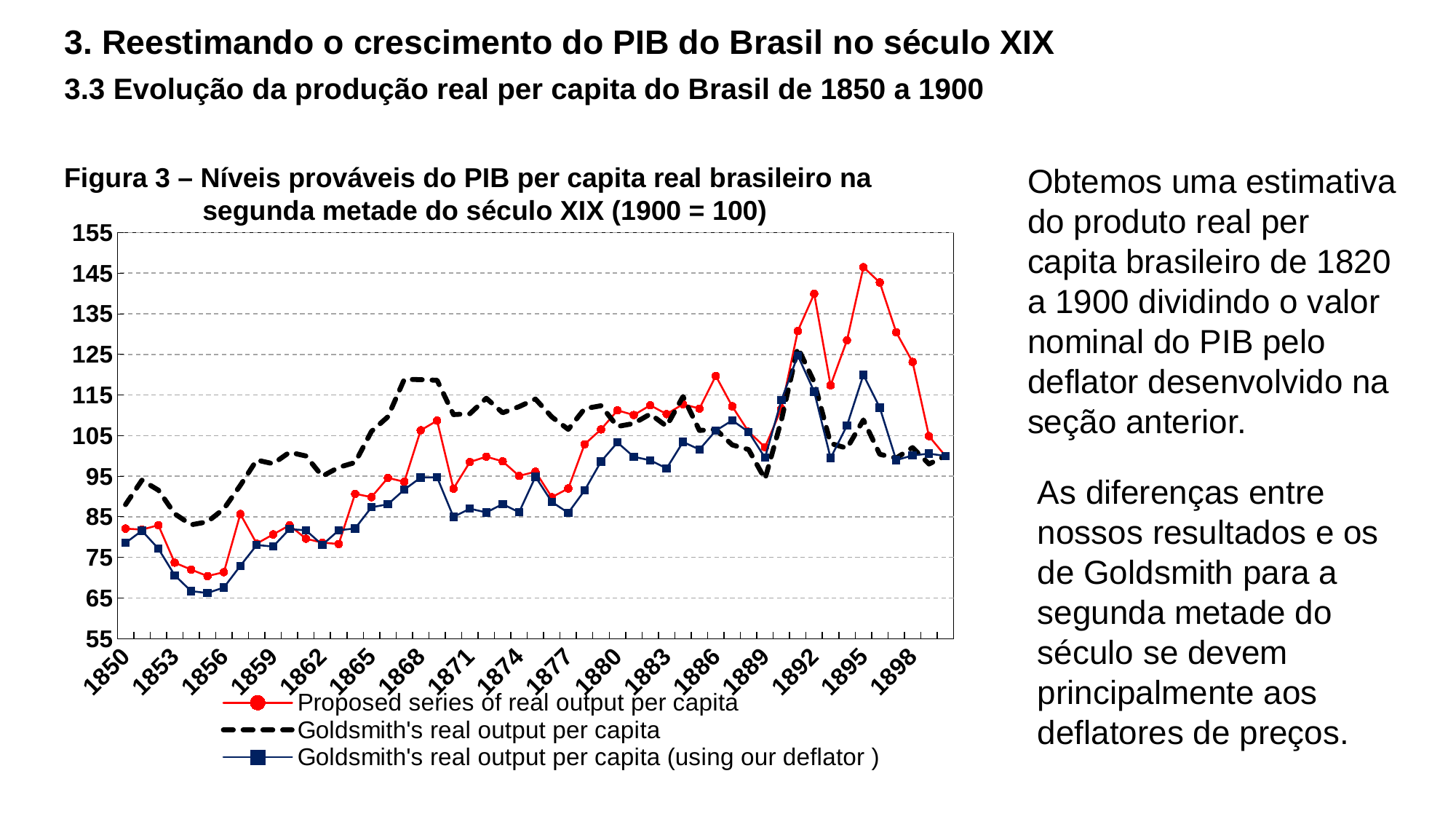
In which year does 'Goldsmith's real output per capita (using our deflator)' reach its highest value? 1891 Which series in Figura 3 is drawn as a black dashed line? Goldsmith's real output per capita How many series does the legend of Figura 3 list? 3 Does the 'Proposed series of real output per capita' rise or fall between 1895 and 1900? fall Is the value of 'Goldsmith's real output per capita (using our deflator)' in 1856 greater or less than 75? less What kind of chart is shown in Figura 3? line chart What base year is indicated in the title of Figura 3 (index = 100)? 1900 Is the value of the 'Proposed series of real output per capita' in 1892 greater or less than 135? greater In which year does the 'Proposed series of real output per capita' reach its highest value? 1895 In 1895, which is larger: the 'Proposed series of real output per capita' or 'Goldsmith's real output per capita' (dashed line)? Proposed series of real output per capita In 1868, which is larger: 'Goldsmith's real output per capita' (dashed line) or the 'Proposed series of real output per capita'? Goldsmith's real output per capita Is the value of 'Goldsmith's real output per capita' (dashed line) in 1868 greater or less than 105? greater